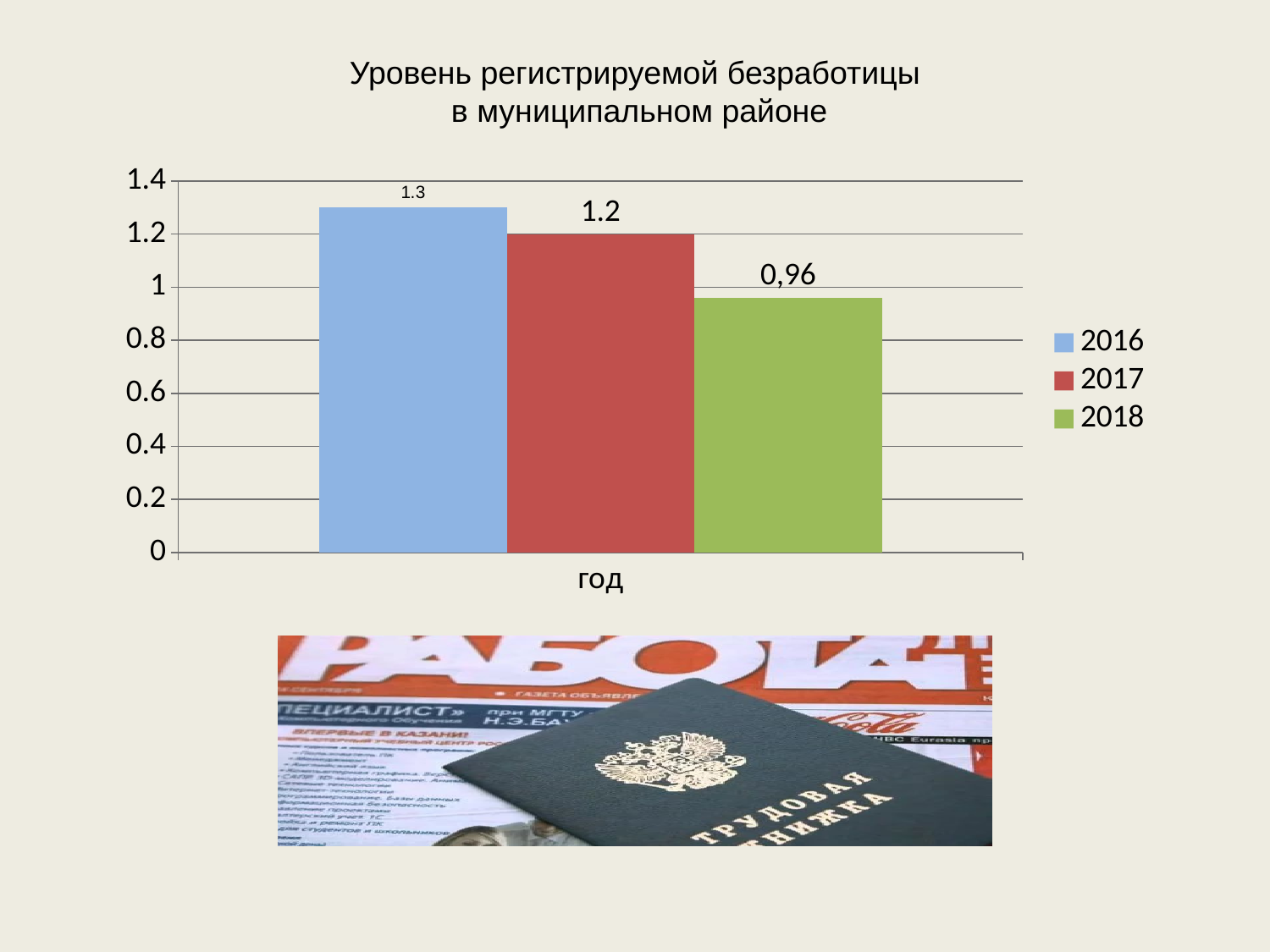
Is the value for 2018 greater or less than 1? less Which year has the lowest registered unemployment level? 2018 Which is larger, the value for 2017 or the value for 2018? 2017 What is the value for 2017? 1.2 What is the value for 2018? 0,96 What kind of chart is shown on the slide? bar chart Which year has the highest registered unemployment level? 2016 What is the difference between the values for 2017 and 2018? 0.24 How many bars are shown in the chart? 3 What is the difference between the values for 2016 and 2017? 0.1 How many entries does the legend list? 3 What is the value for 2016? 1.3